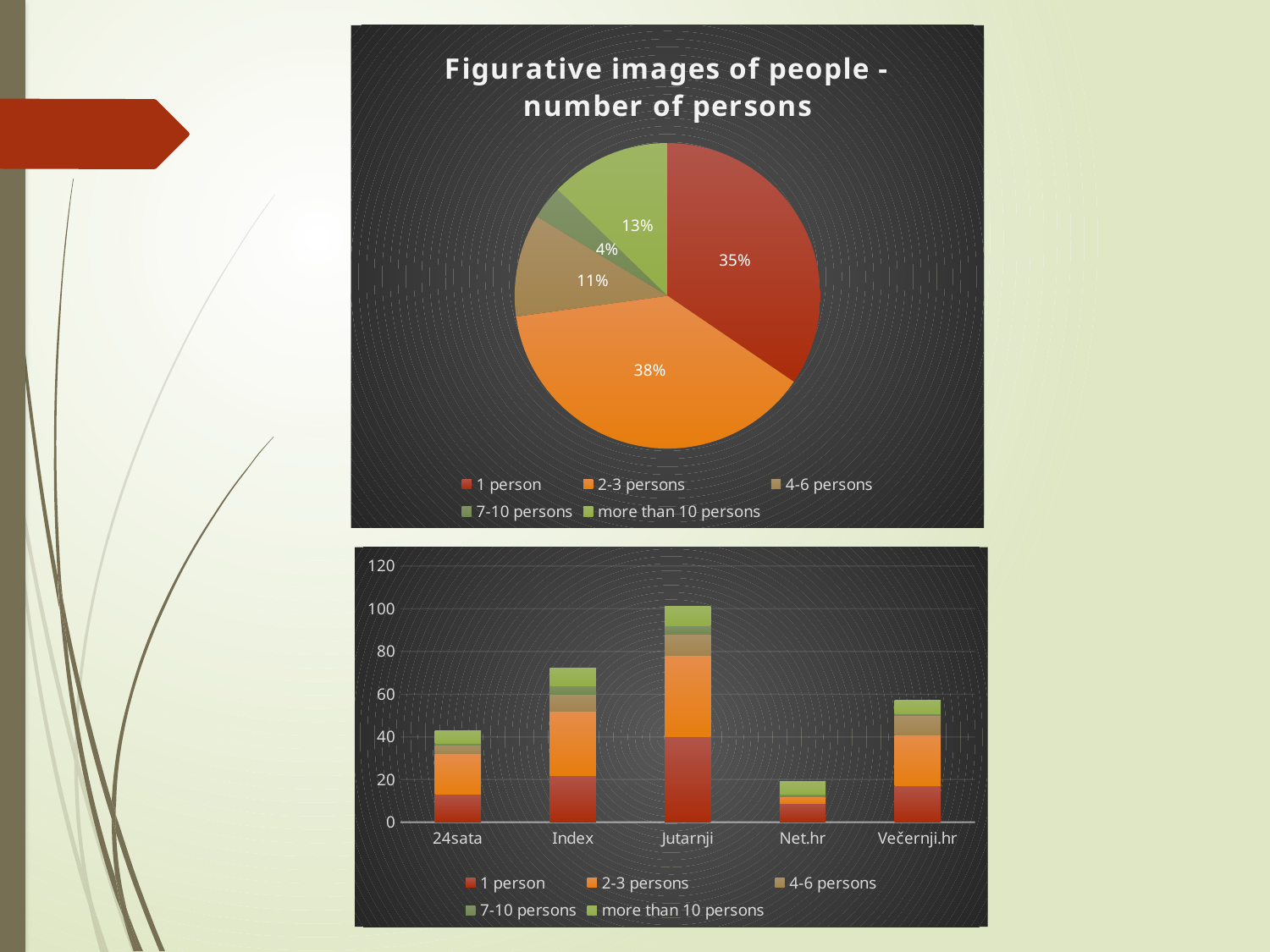
In the bottom bar chart, how many series does the legend list? 5 What kind of chart is the bottom chart on the slide? stacked bar chart In the pie chart titled "Figurative images of people - number of persons", what share is shown for 2-3 persons? 38% What kind of chart is the top chart on the slide? pie chart In the pie chart titled "Figurative images of people - number of persons", what share is shown for 1 person? 35% In the pie chart titled "Figurative images of people - number of persons", what share is shown for 7-10 persons? 4% In the bottom bar chart, how many categories are shown on the x axis? 5 In the pie chart titled "Figurative images of people - number of persons", which is larger: the share for 4-6 persons or the share for more than 10 persons? more than 10 persons In the pie chart titled "Figurative images of people - number of persons", which category has the largest share? 2-3 persons In the pie chart titled "Figurative images of people - number of persons", which category has the smallest share? 7-10 persons In the bottom bar chart, is the total height of the Jutarnji bar greater or less than 80? greater In the pie chart titled "Figurative images of people - number of persons", how many slices does the pie have? 5